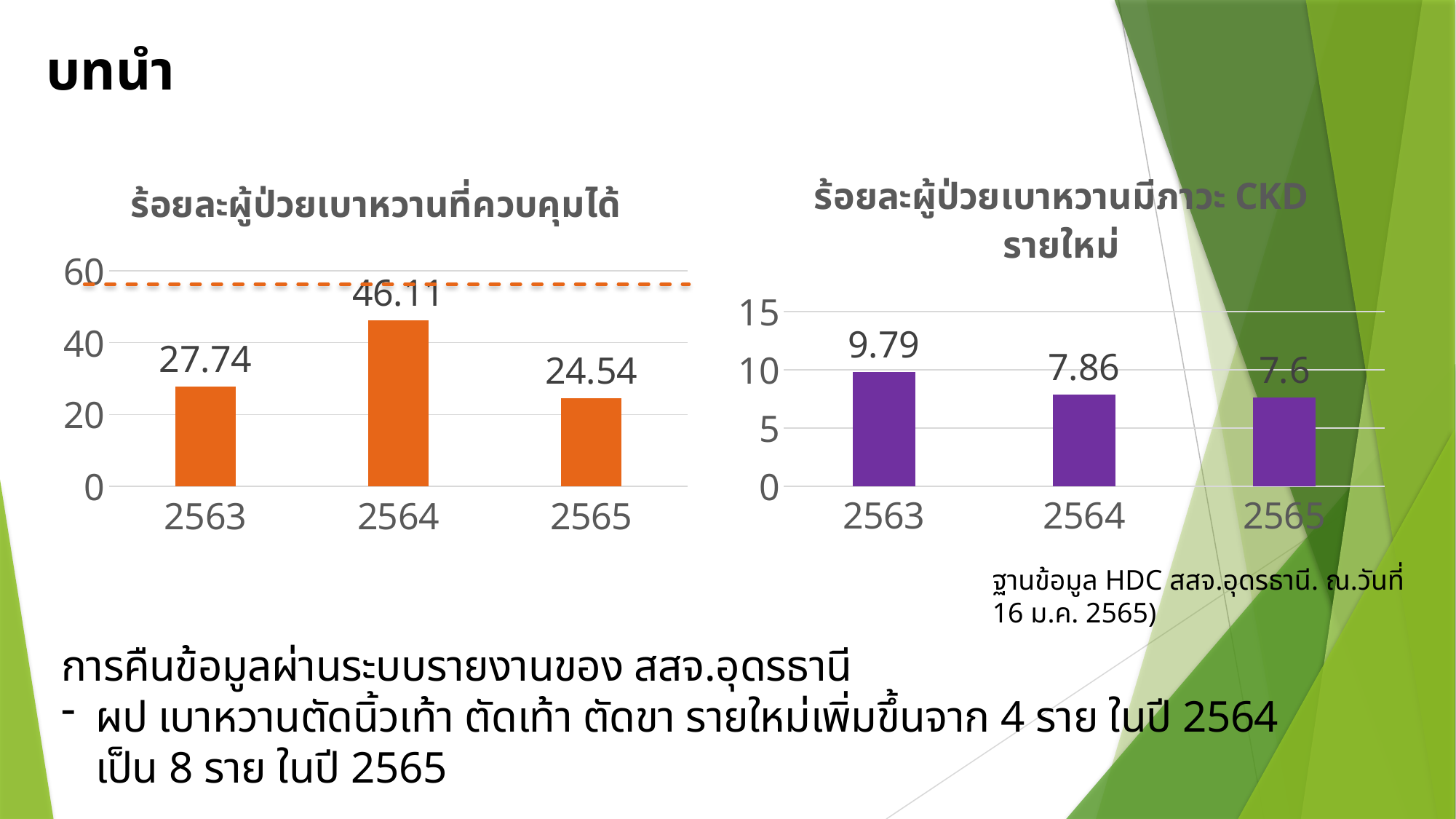
In the left chart (ร้อยละผู้ป่วยเบาหวานที่ควบคุมได้), which year has the highest value? 2564 How many years are shown on the x axis of the left chart (ร้อยละผู้ป่วยเบาหวานที่ควบคุมได้)? 3 In the right chart (ร้อยละผู้ป่วยเบาหวานมีภาวะ CKD รายใหม่), which year has the highest value? 2563 In the right chart (ร้อยละผู้ป่วยเบาหวานมีภาวะ CKD รายใหม่), do the values rise or fall from 2563 to 2565? fall In the left chart (ร้อยละผู้ป่วยเบาหวานที่ควบคุมได้), what is the difference between the values for 2564 and 2563? 18.37 In the left chart (ร้อยละผู้ป่วยเบาหวานที่ควบคุมได้), which year has the lowest value? 2565 What type of chart is the right chart (ร้อยละผู้ป่วยเบาหวานมีภาวะ CKD รายใหม่)? bar chart In the right chart (ร้อยละผู้ป่วยเบาหวานมีภาวะ CKD รายใหม่), what is the value for 2563? 9.79 In the left chart (ร้อยละผู้ป่วยเบาหวานที่ควบคุมได้), what is the value for 2565? 24.54 In the right chart (ร้อยละผู้ป่วยเบาหวานมีภาวะ CKD รายใหม่), what is the value for 2565? 7.6 In the left chart (ร้อยละผู้ป่วยเบาหวานที่ควบคุมได้), what is the value for 2564? 46.11 In the right chart (ร้อยละผู้ป่วยเบาหวานมีภาวะ CKD รายใหม่), what is the difference between the values for 2563 and 2564? 1.93